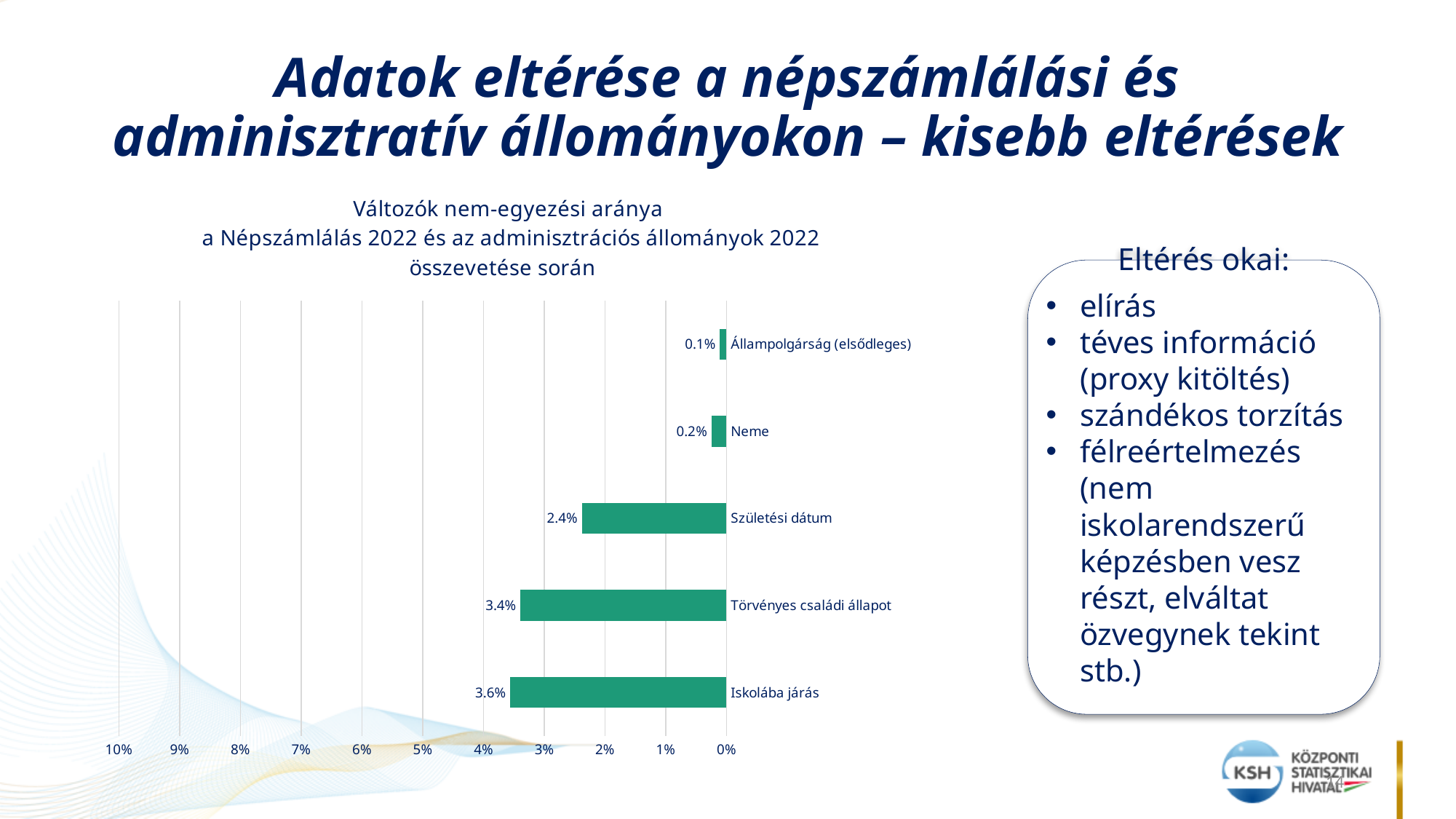
What is the value shown for Állampolgárság (elsődleges)? 0.1% What is the difference between the values for Iskolába járás and Törvényes családi állapot? 0.2% What kind of chart is shown on the slide? Bar chart What is the value shown for Születési dátum? 2.4% What is the non-match rate for Iskolába járás? 3.6% Which has a larger value, Születési dátum or Neme? Születési dátum Which category has the lowest non-match rate? Állampolgárság (elsődleges) How many categories are plotted in the chart? 5 What is the value shown for Neme? 0.2% What is the difference between the values for Törvényes családi állapot and Születési dátum? 1.0% What is the maximum value shown on the chart's percentage axis? 10% Which category has the highest non-match rate? Iskolába járás